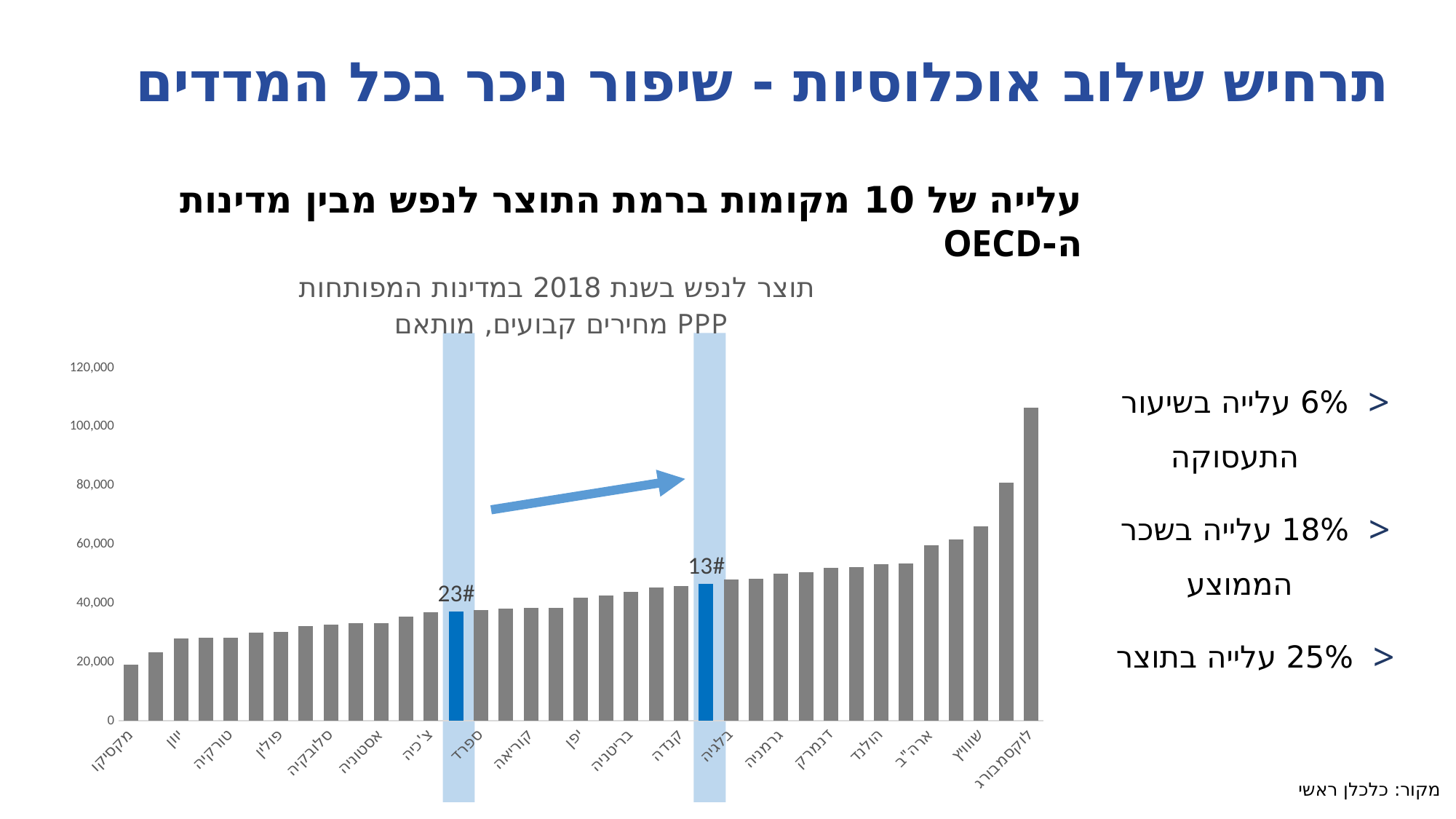
Which country has the lowest bar in the chart? מקסיקו Which country has the highest bar in the chart? לוקסמבורג Is the value for שוויץ greater or less than 60,000? greater Is the value for בלגיה greater or less than 40,000? greater Is the value for לוקסמבורג greater or less than 100,000? greater What is the highest value shown on the y axis? 120,000 Do the bar values rise or fall moving from left to right along the x axis? Rise What kind of chart is shown on the slide? Bar chart Which has the larger value, בלגיה or ספרד? בלגיה